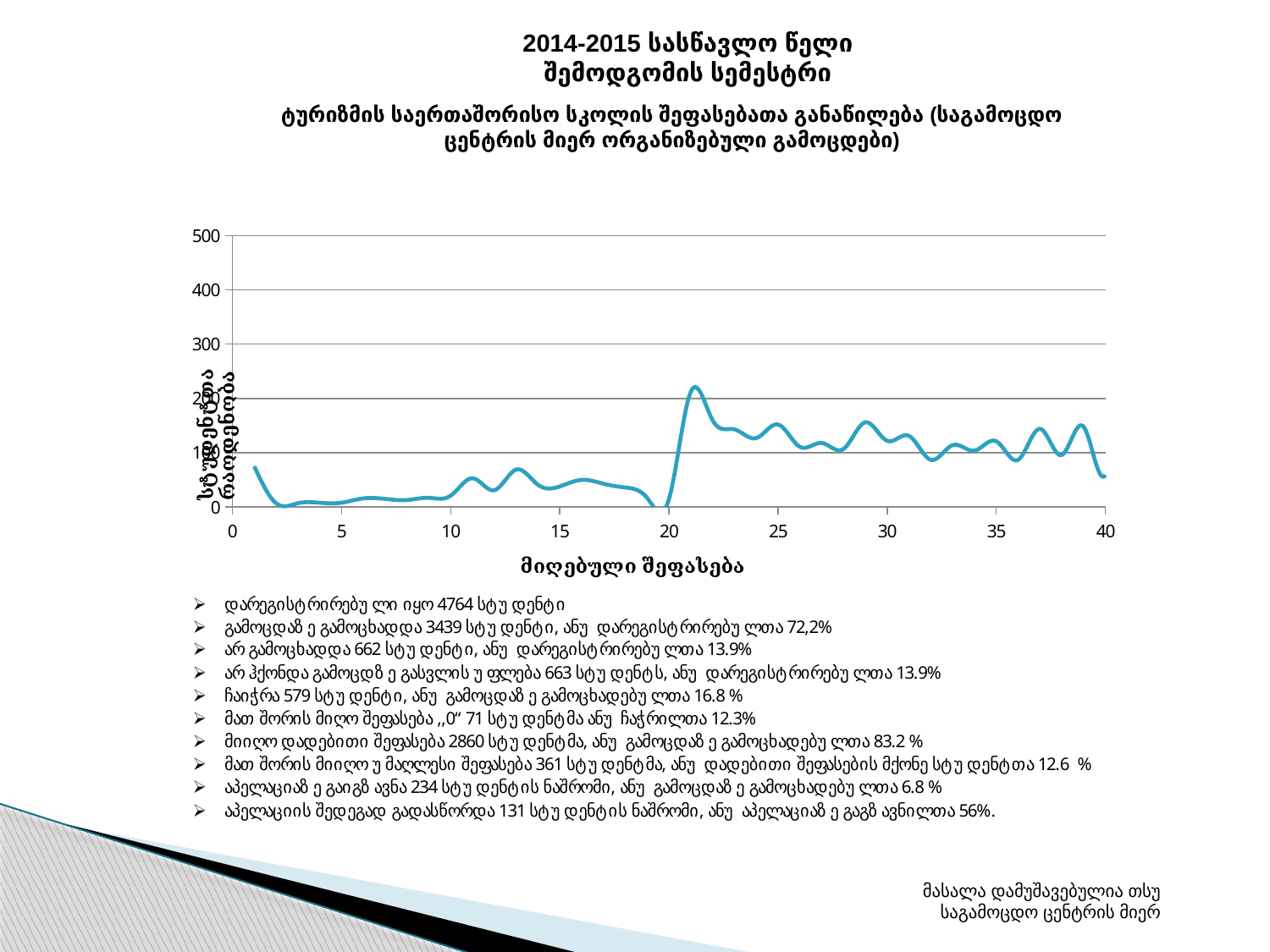
Is the value for score 10 greater or less than 100? less Is the value for score 21 greater or less than 300? less What is the title of the x axis? მიღებული შეფასება What is the highest tick value shown on the y axis? 500 Is the value for score 2 greater or less than 100? less Does the line rise or fall between score 20 and score 21? rise At which score on the x axis does the line reach its highest value? 21 Which has the larger value, score 13 or score 29? score 29 What kind of chart is shown on the slide? line chart Which has the larger value, score 21 or score 10? score 21